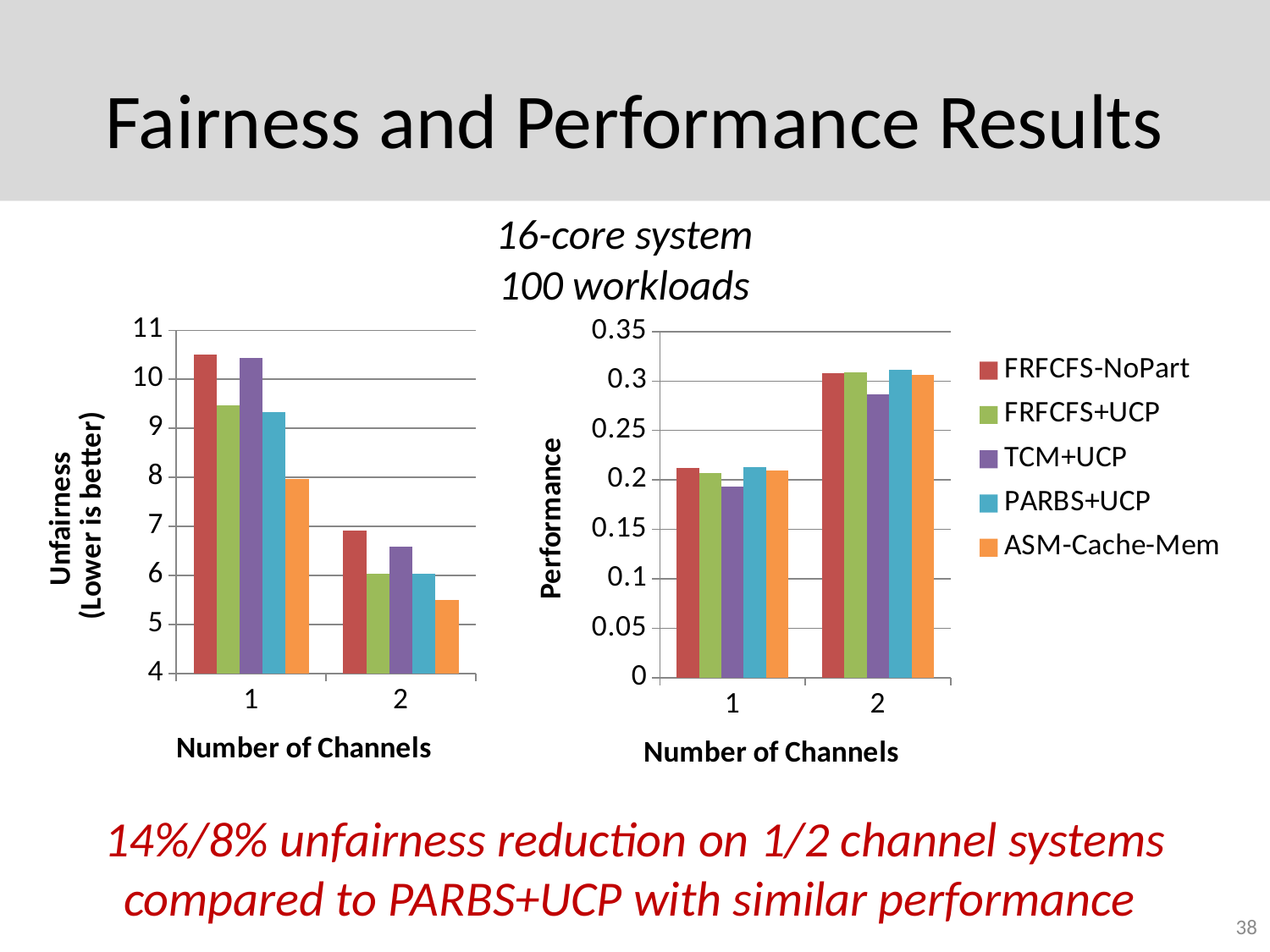
What is the y-axis title of the left chart? Unfairness (Lower is better) In the left chart (Unfairness), is the value for ASM-Cache-Mem at 2 channels greater or less than 6? less How many series does the legend list? 5 In the left chart (Unfairness), which is larger at 2 channels: FRFCFS-NoPart or ASM-Cache-Mem? FRFCFS-NoPart What kind of chart is the left chart (Unfairness)? bar chart In the left chart (Unfairness), how many Number of Channels categories are shown on the x axis? 2 In the right chart (Performance), which series has the lowest performance for 1 channel? TCM+UCP In the right chart (Performance), is the value for FRFCFS-NoPart at 2 channels greater or less than 0.25? greater In the left chart (Unfairness), which series has the lowest unfairness for 1 channel? ASM-Cache-Mem In the left chart (Unfairness), does the ASM-Cache-Mem value rise or fall from 1 channel to 2 channels? fall In the left chart (Unfairness), is the value for FRFCFS-NoPart at 1 channel greater or less than 10? greater In the left chart (Unfairness), which series has the highest unfairness for 2 channels? FRFCFS-NoPart